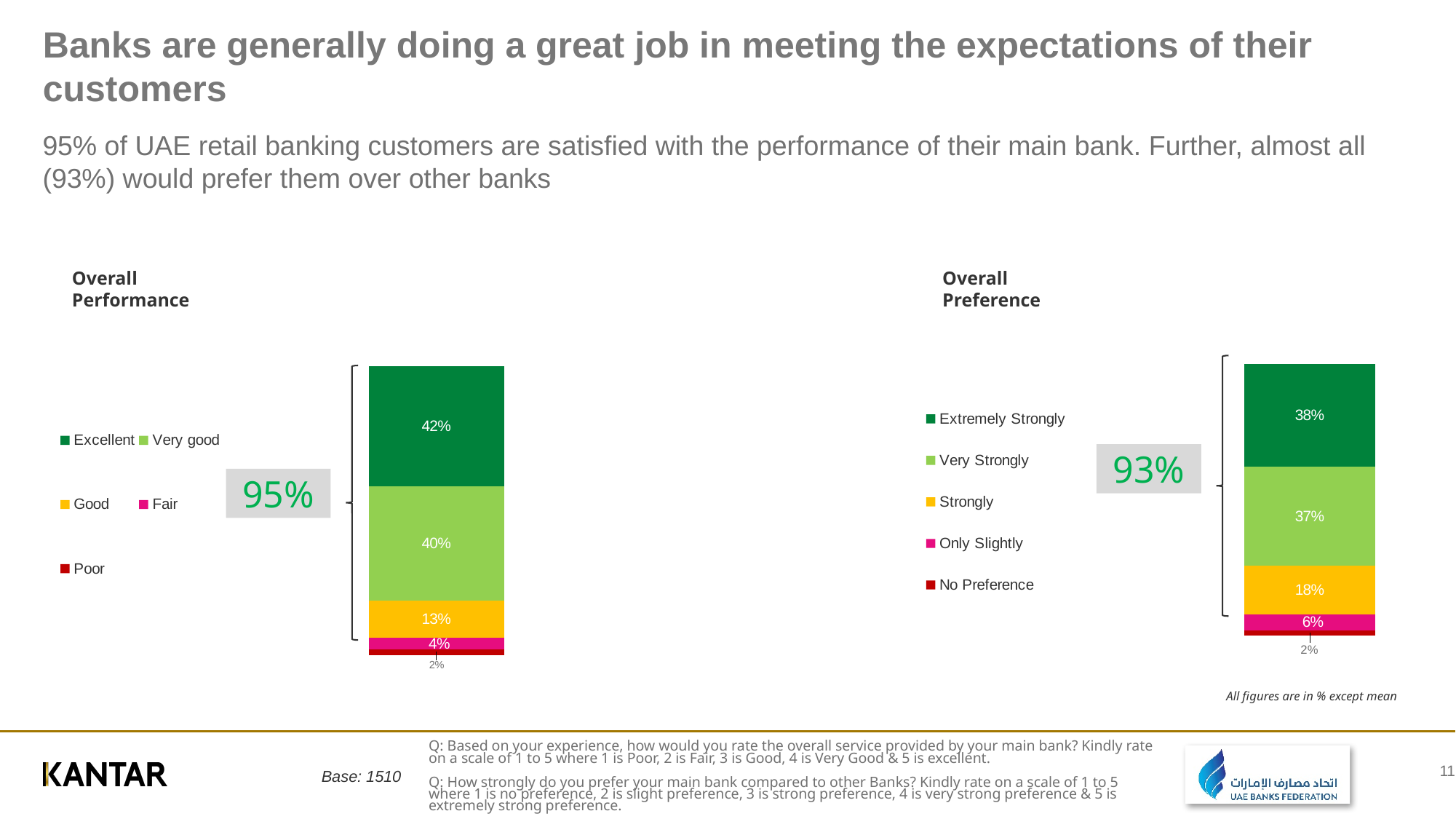
In the Overall Performance chart, what is the difference between the Very good and Good percentages? 27% In the Overall Performance chart, what is the combined total of the Excellent, Very good and Good segments? 95% How many series does the legend of the Overall Preference chart list? 5 In the Overall Preference chart, what percentage of customers have No Preference? 2% In the Overall Performance chart, what percentage of customers rated their main bank as Good? 13% In the Overall Preference chart, which category has the smallest share? No Preference In the Overall Performance chart, what percentage of customers rated their main bank as Excellent? 42% In the Overall Preference chart, which is larger: the Strongly share or the Only Slightly share? Strongly In the Overall Performance chart, which rating category has the largest share? Excellent In the Overall Preference chart, what percentage of customers prefer their main bank Very Strongly? 37% In the Overall Preference chart, what is the difference between the Strongly and Only Slightly percentages? 12% What type of chart is the Overall Performance chart? Stacked bar chart